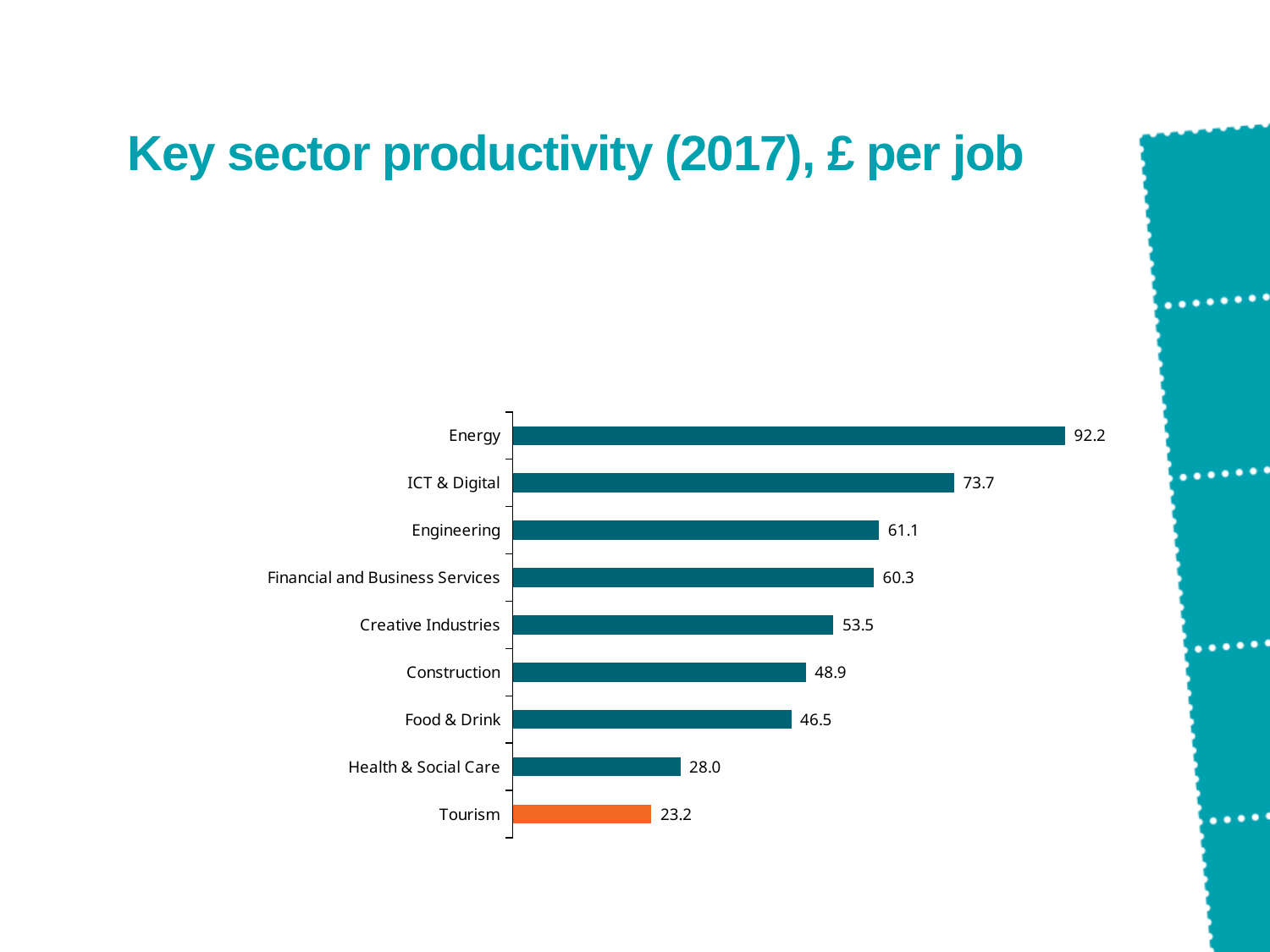
Which sector's bar is coloured orange rather than teal? Tourism What is the productivity value for Energy? 92.2 What type of chart is shown on the slide? Bar chart How many sectors are shown in the chart? 9 Which sector has the lowest productivity? Tourism Which sector has the highest productivity? Energy What is the difference between the values for Construction and Food & Drink? 2.4 Which has a larger value, Engineering or Financial and Business Services? Engineering What is the productivity value for Health & Social Care? 28.0 What is the difference between the values for Energy and ICT & Digital? 18.5 What is the productivity value for Tourism? 23.2 What is the productivity value for Creative Industries? 53.5